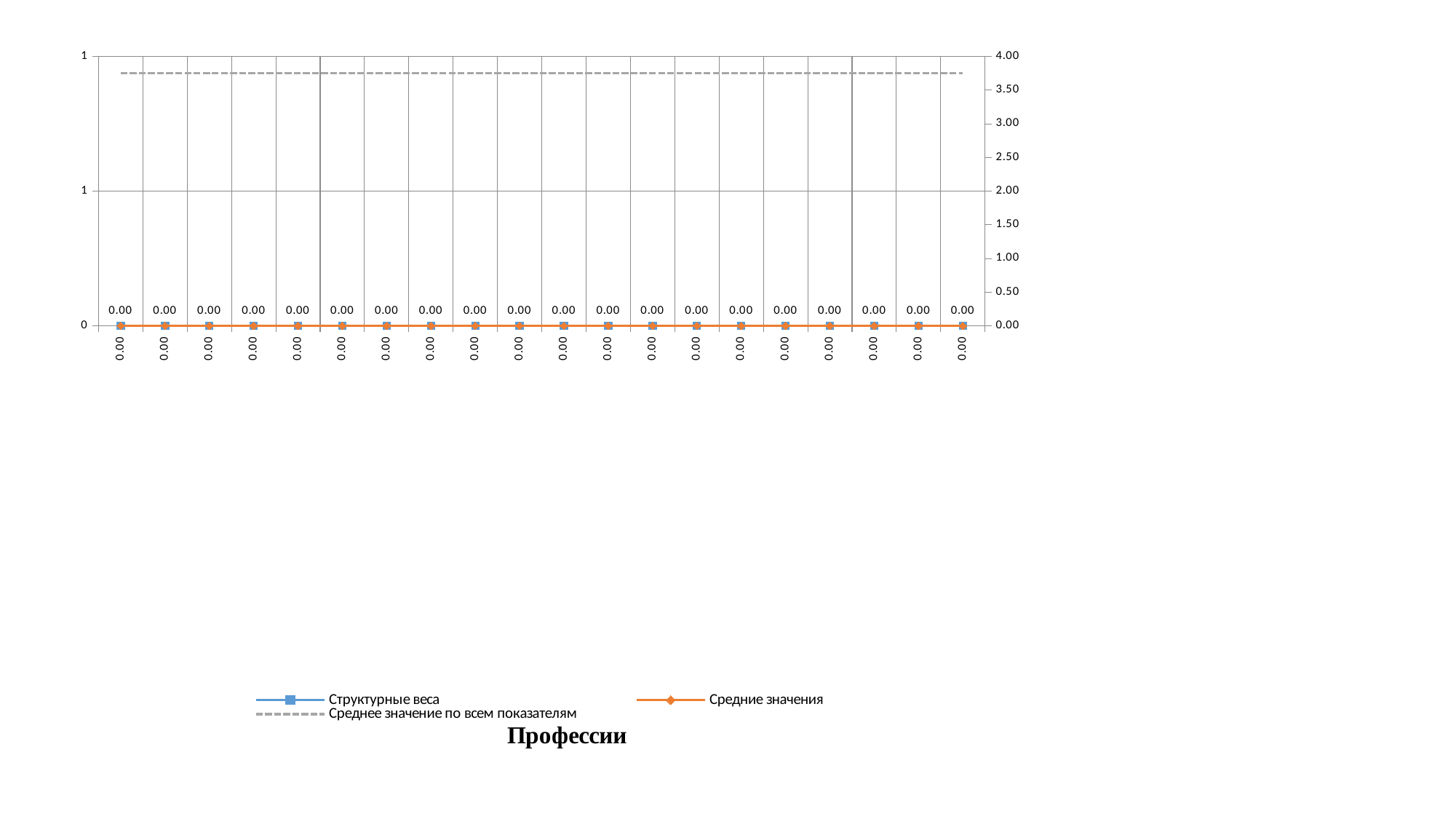
What kind of chart is shown on the slide? line chart What value is printed on the data labels for the plotted points? 0.00 What is the title shown below the chart? Профессии How many data points are plotted along the x axis? 20 Is the dashed line for Среднее значение по всем показателям greater or less than 3.50 on the right axis? greater What is the highest tick value shown on the right-hand axis? 4.00 How many series does the legend list? 3 Is the dashed line for Среднее значение по всем показателям greater or less than 4.00 on the right axis? less Do the values of the Структурные веса series rise, fall or stay flat along the x axis? stay flat